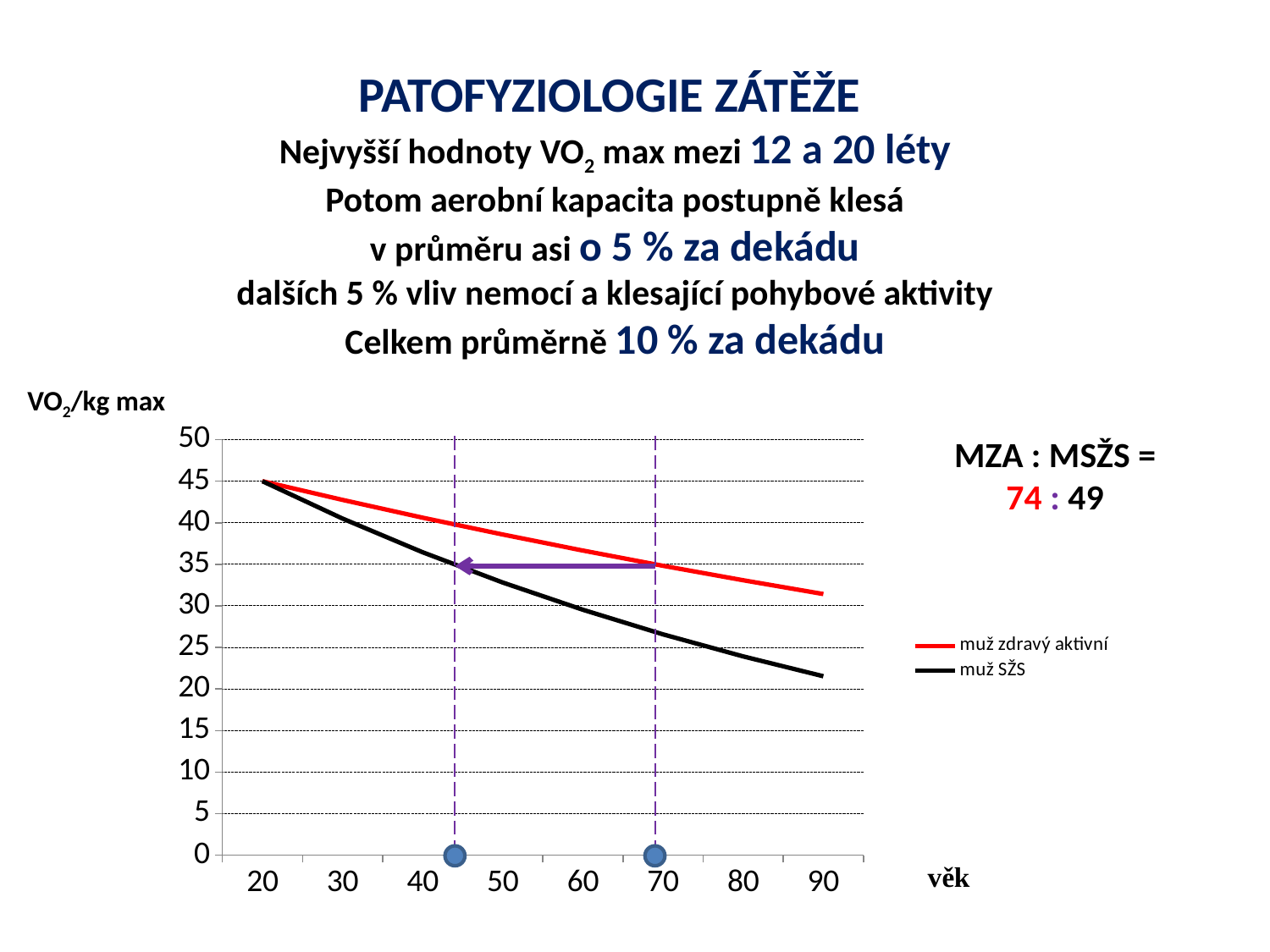
Is the value of 'muž zdravý aktivní' at age 90 greater or less than 30? greater Is the value of 'muž SŽS' at age 50 greater or less than 35? less How many series does the chart legend list? 2 What are the two series named in the chart legend? muž zdravý aktivní, muž SŽS At age 90, which series has the higher value, 'muž zdravý aktivní' or 'muž SŽS'? muž zdravý aktivní Which colour is used for the 'muž SŽS' line? black Is the value of 'muž SŽS' at age 90 greater or less than 25? less Do the values of both lines rise or fall as age (věk) increases? fall What is the highest age shown on the x axis of the chart? 90 What kind of chart is shown on the slide? line chart What is the VO2/kg max value of both lines at age 20? 45